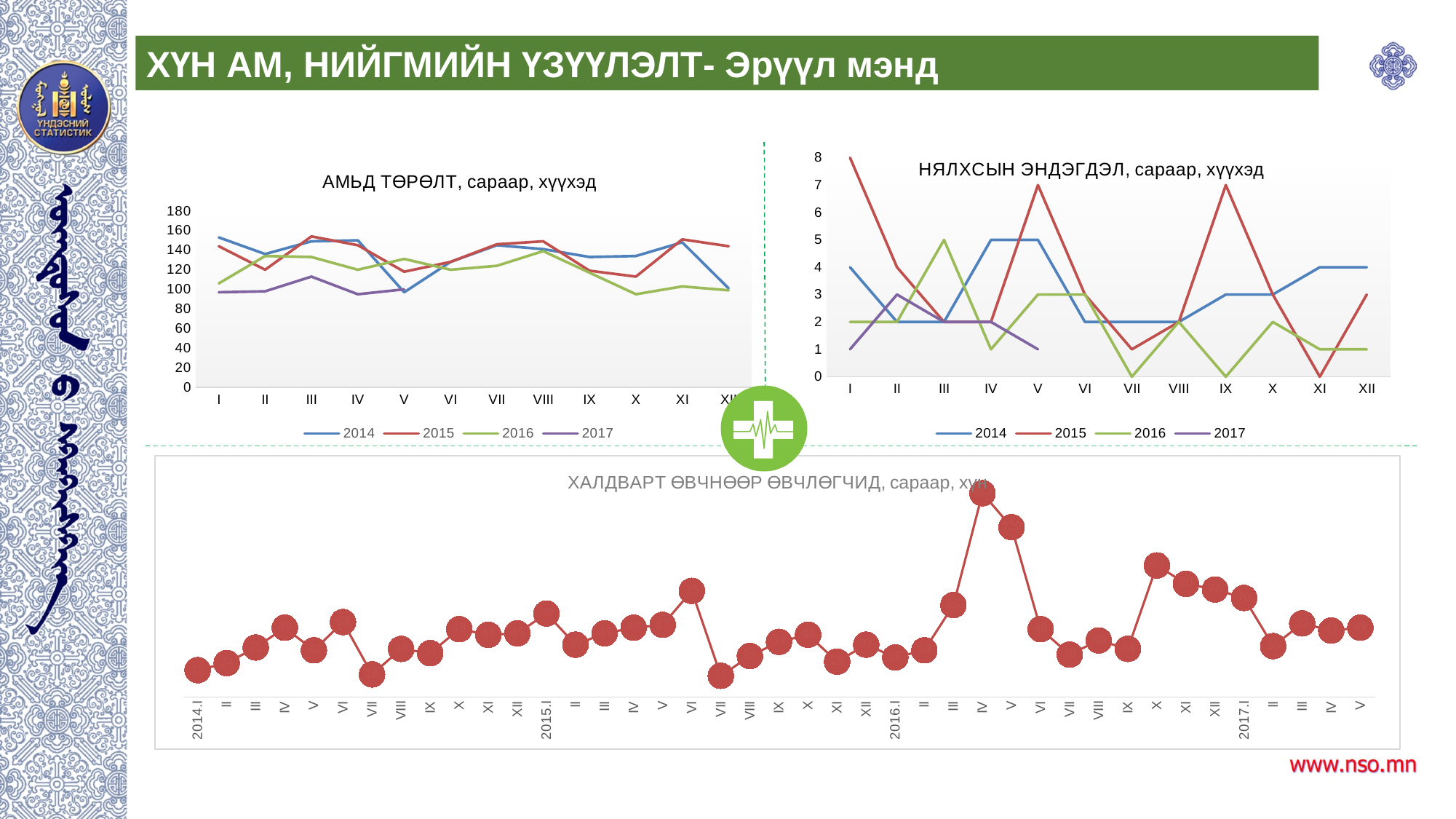
In the chart titled 'АМЬД ТӨРӨЛТ, сараар, хүүхэд', is the value for 2016 in month X greater or less than 100? less In the chart titled 'ХАЛДВАРТ ӨВЧНӨӨР ӨВЧЛӨГЧИД, сараар, хүн', which month has the highest value? 2016.IV In the chart titled 'НЯЛХСЫН ЭНДЭГДЭЛ, сараар, хүүхэд', which is larger in month V: the 2015 value or the 2014 value? 2015 In the chart titled 'АМЬД ТӨРӨЛТ, сараар, хүүхэд', is the value for 2017 in month III greater or less than 100? greater In the chart titled 'НЯЛХСЫН ЭНДЭГДЭЛ, сараар, хүүхэд', what is the value for 2016 in month III? 5 In the chart titled 'НЯЛХСЫН ЭНДЭГДЭЛ, сараар, хүүхэд', what is the value for 2015 in month I? 8 In the chart titled 'НЯЛХСЫН ЭНДЭГДЭЛ, сараар, хүүхэд', which month has the highest value for the 2015 series? I What kind of chart is the chart titled 'ХАЛДВАРТ ӨВЧНӨӨР ӨВЧЛӨГЧИД, сараар, хүн'? line chart How many series does the legend list in the chart titled 'АМЬД ТӨРӨЛТ, сараар, хүүхэд'? 4 In the chart titled 'НЯЛХСЫН ЭНДЭГДЭЛ, сараар, хүүхэд', what is the value for 2017 in month II? 3 How many months are plotted on the x axis of the chart titled 'АМЬД ТӨРӨЛТ, сараар, хүүхэд'? 12 In the chart titled 'НЯЛХСЫН ЭНДЭГДЭЛ, сараар, хүүхэд', what is the difference between the 2015 value in month I and the 2014 value in month I? 4